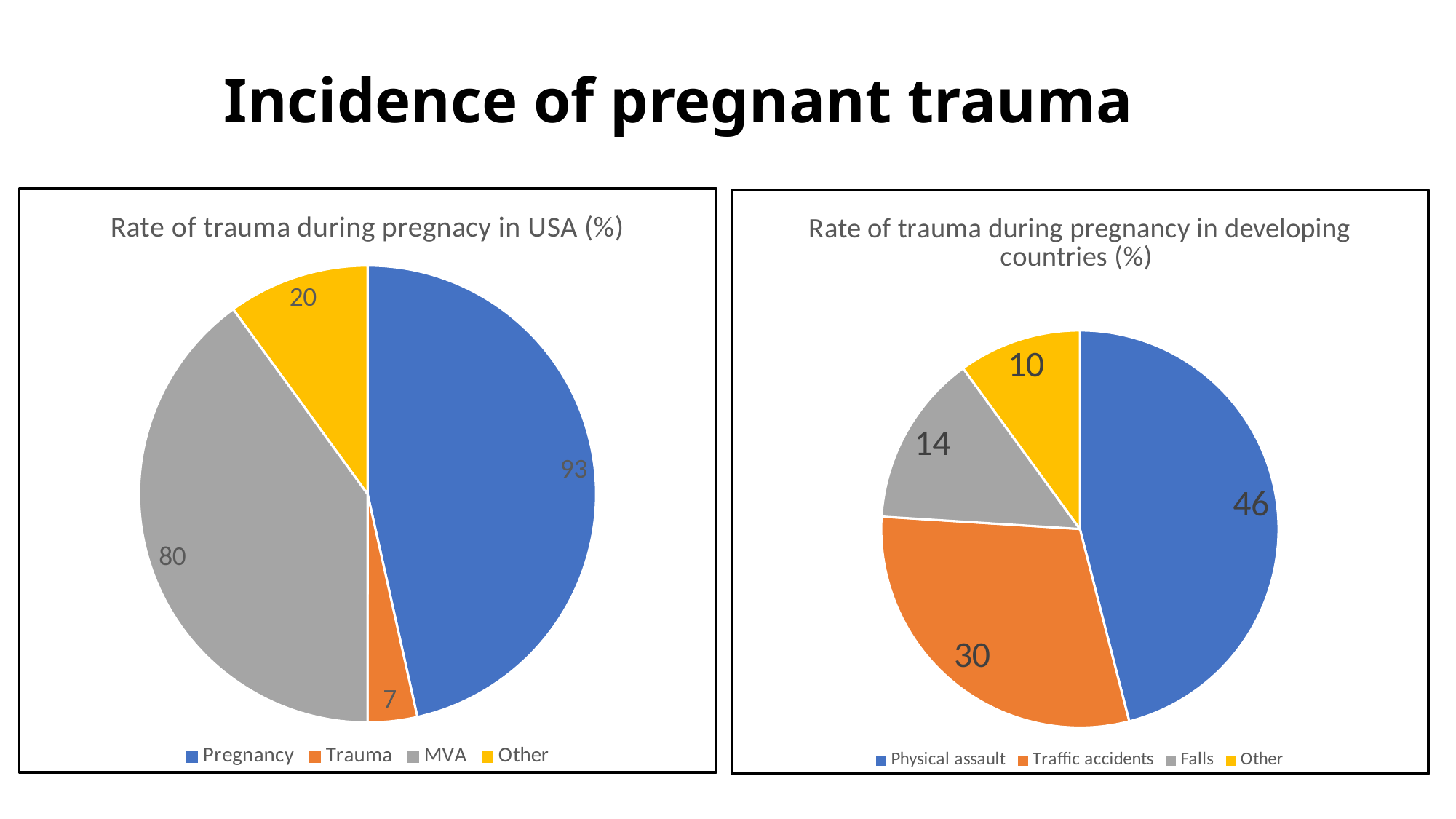
In the right chart, 'Rate of trauma during pregnancy in developing countries (%)', what colour is the Falls slice? Grey What type of chart is the left chart, 'Rate of trauma during pregnacy in USA (%)'? Pie chart In the right chart, 'Rate of trauma during pregnancy in developing countries (%)', which category has the smallest slice? Other In the right chart, 'Rate of trauma during pregnancy in developing countries (%)', what is the value for Falls? 14 In the left chart, 'Rate of trauma during pregnacy in USA (%)', which is larger, Other or Trauma? Other In the right chart, 'Rate of trauma during pregnancy in developing countries (%)', what is the difference between Physical assault and Traffic accidents? 16 In the left chart, 'Rate of trauma during pregnacy in USA (%)', what is the value for Trauma? 7 How many slices does the right chart, 'Rate of trauma during pregnancy in developing countries (%)', have? 4 In the left chart, 'Rate of trauma during pregnacy in USA (%)', what is the value for MVA? 80 In the right chart, 'Rate of trauma during pregnancy in developing countries (%)', what is the value for Traffic accidents? 30 In the left chart, 'Rate of trauma during pregnacy in USA (%)', what is the difference between Pregnancy and MVA? 13 In the left chart, 'Rate of trauma during pregnacy in USA (%)', which category has the largest slice? Pregnancy